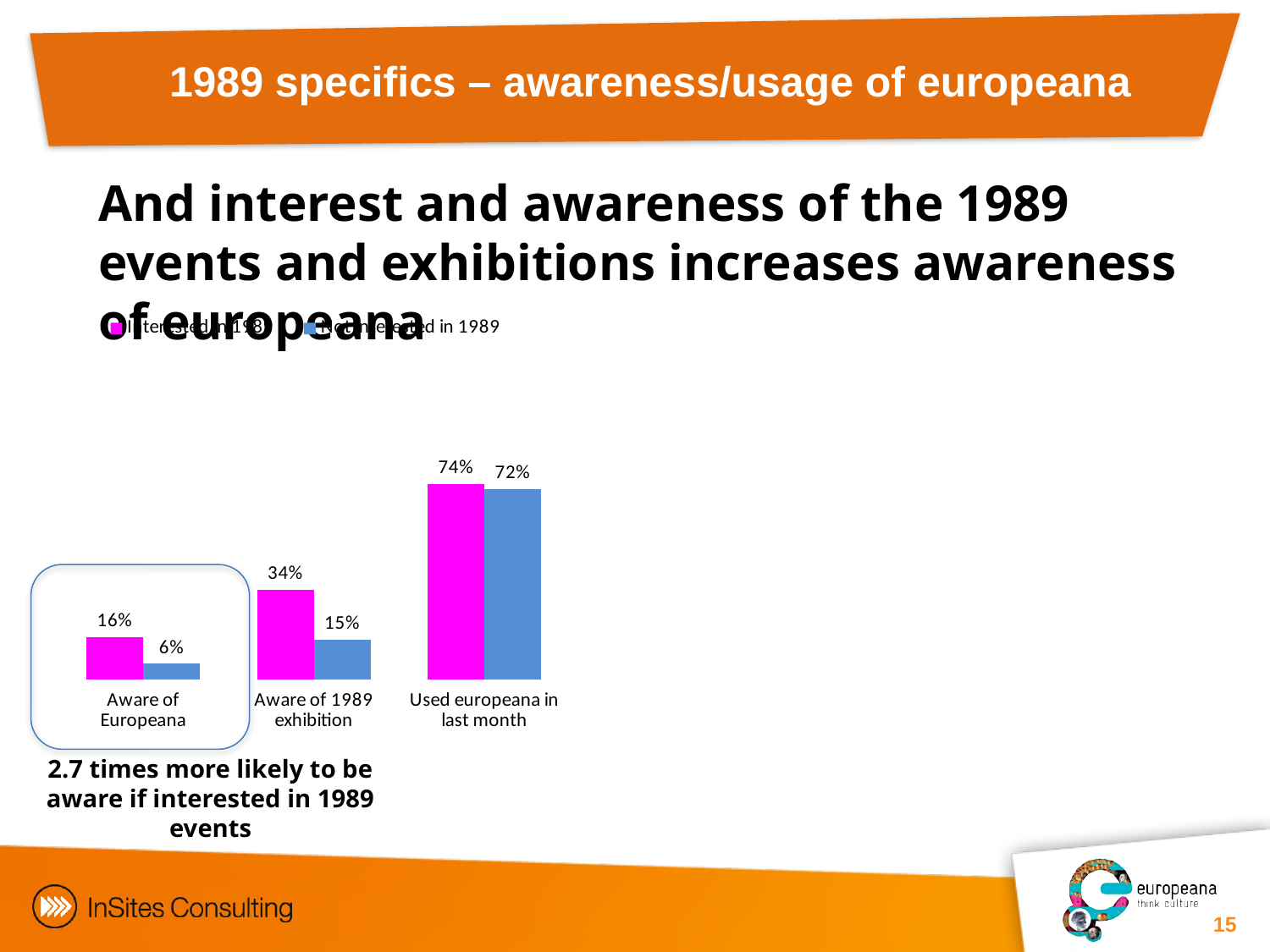
Which category has the highest value for the magenta series? Used europeana in last month What is the difference between the magenta and blue bars for "Aware of 1989 exhibition"? 19% What is the value of the magenta bar for "Aware of Europeana"? 16% What is the difference between the magenta and blue bars for "Aware of Europeana"? 10% What is the value of the blue bar for "Used europeana in last month"? 72% What kind of chart is shown on the slide? bar chart How many series does the chart's legend list? 2 For "Used europeana in last month", which bar is larger, the magenta or the blue one? magenta What is the value of the blue bar for "Aware of Europeana"? 6% Which category has the lowest value for the blue series? Aware of Europeana What is the value of the magenta bar for "Aware of 1989 exhibition"? 34% How many categories are shown on the x axis of the chart? 3